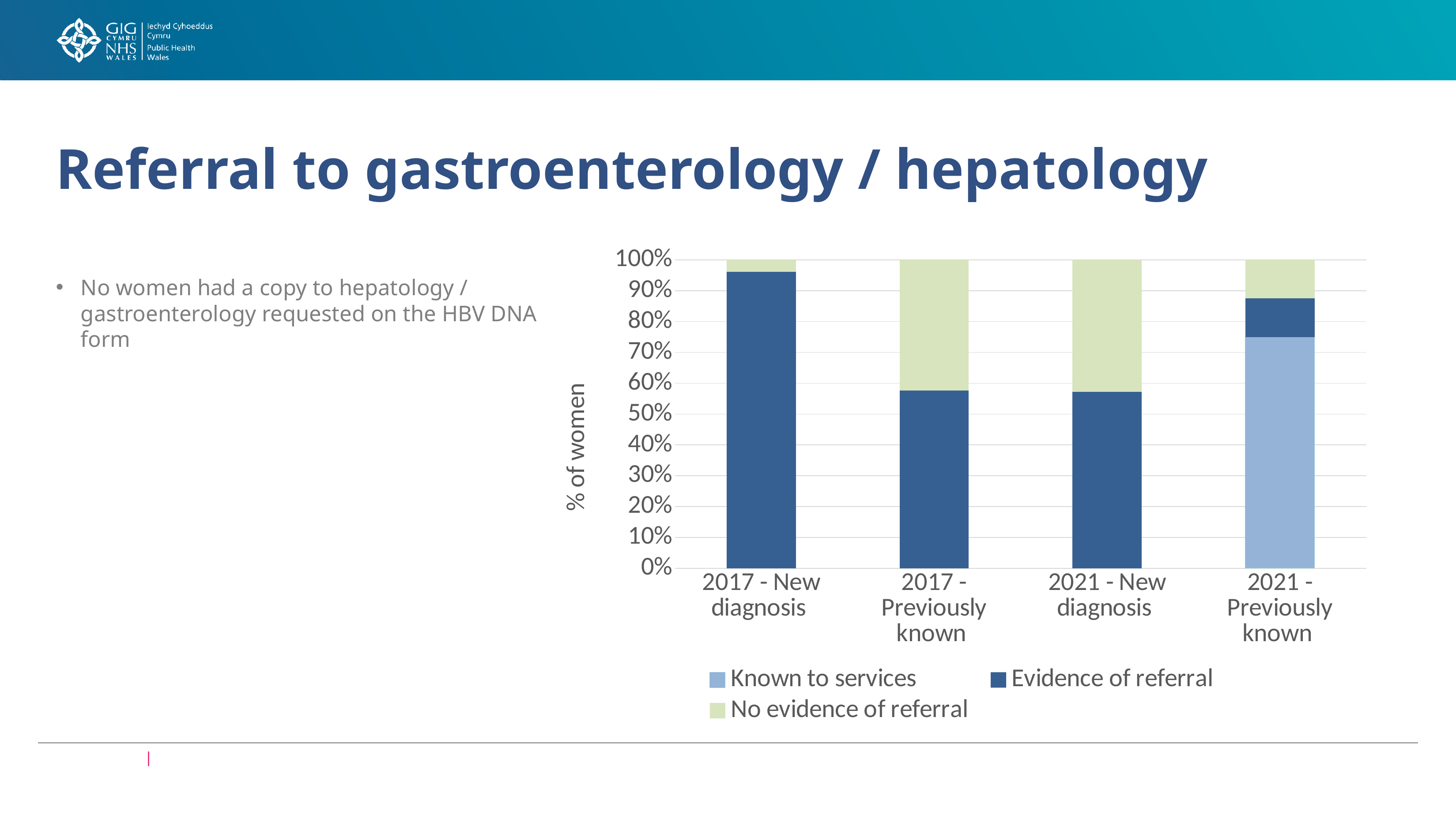
Which series in the legend is shown in light green? No evidence of referral Is the Evidence of referral value for 2021 - New diagnosis greater or less than 60%? less Which has the larger Evidence of referral value: 2017 - New diagnosis or 2021 - New diagnosis? 2017 - New diagnosis Which category has the largest Evidence of referral segment? 2017 - New diagnosis Is the Evidence of referral value for 2017 - Previously known greater or less than 50%? greater Is the Known to services value for 2021 - Previously known greater or less than 70%? greater What kind of chart is shown on the slide? Stacked bar chart How many categories are shown on the x axis of the chart? 4 What is the label of the vertical axis of the chart? % of women How many series does the chart legend list? 3 Which category has the smallest Evidence of referral segment? 2021 - Previously known